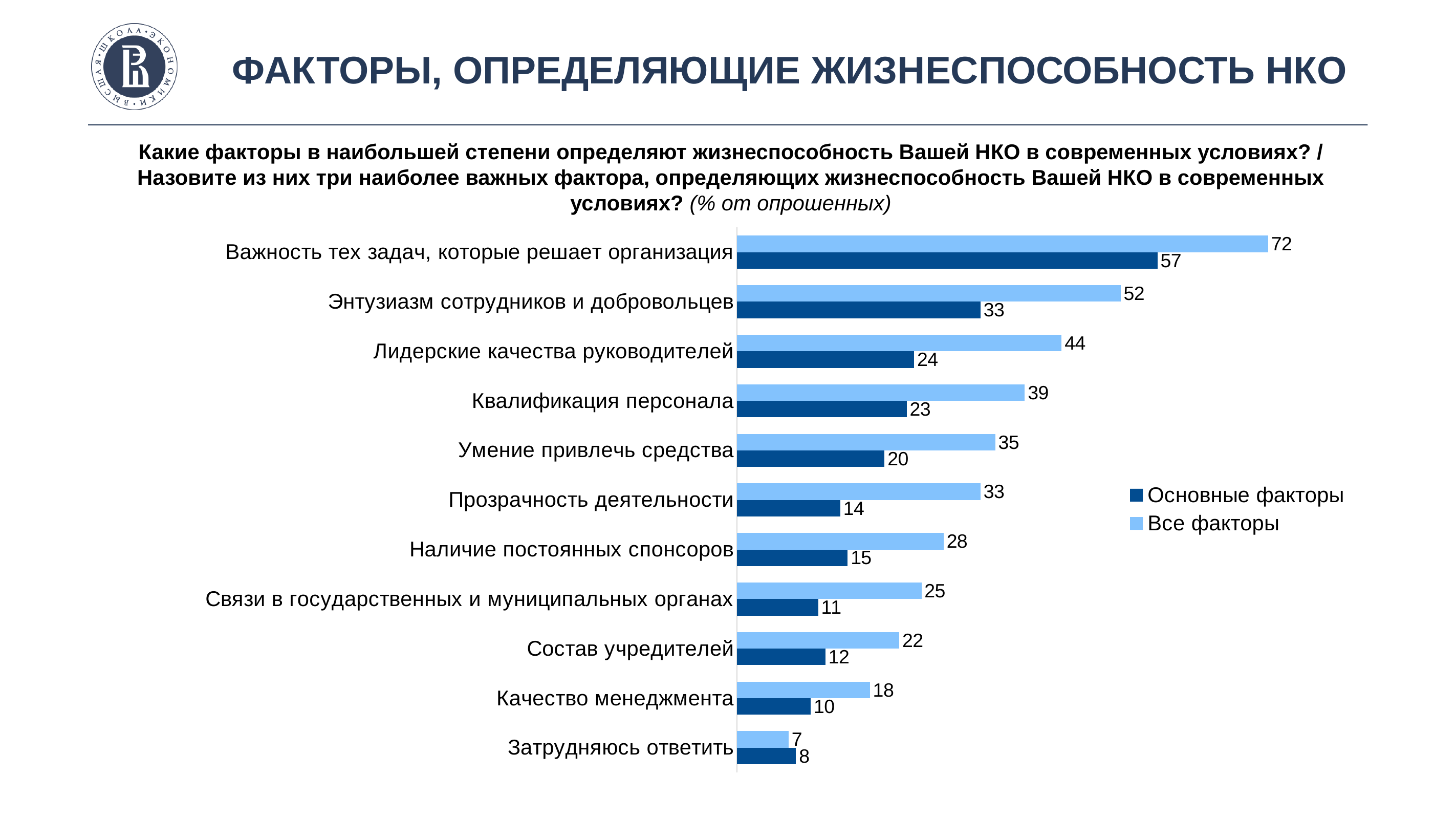
What is the value of "Все факторы" for "Прозрачность деятельности"? 33 Which category has the lowest value for "Все факторы"? Затрудняюсь ответить What is the value of "Основные факторы" for "Качество менеджмента"? 10 Which is larger: "Основные факторы" for "Наличие постоянных спонсоров" or "Основные факторы" for "Состав учредителей"? Наличие постоянных спонсоров What is the value of "Все факторы" for "Важность тех задач, которые решает организация"? 72 Which category has the highest value for "Все факторы"? Важность тех задач, которые решает организация What is the value of "Основные факторы" for "Энтузиазм сотрудников и добровольцев"? 33 For "Затрудняюсь ответить", which series has the larger value: "Основные факторы" or "Все факторы"? Основные факторы How many series does the legend list? 2 What is the difference between "Все факторы" and "Основные факторы" for "Лидерские качества руководителей"? 20 How many categories are shown in the chart? 11 What type of chart is shown on the slide? Bar chart